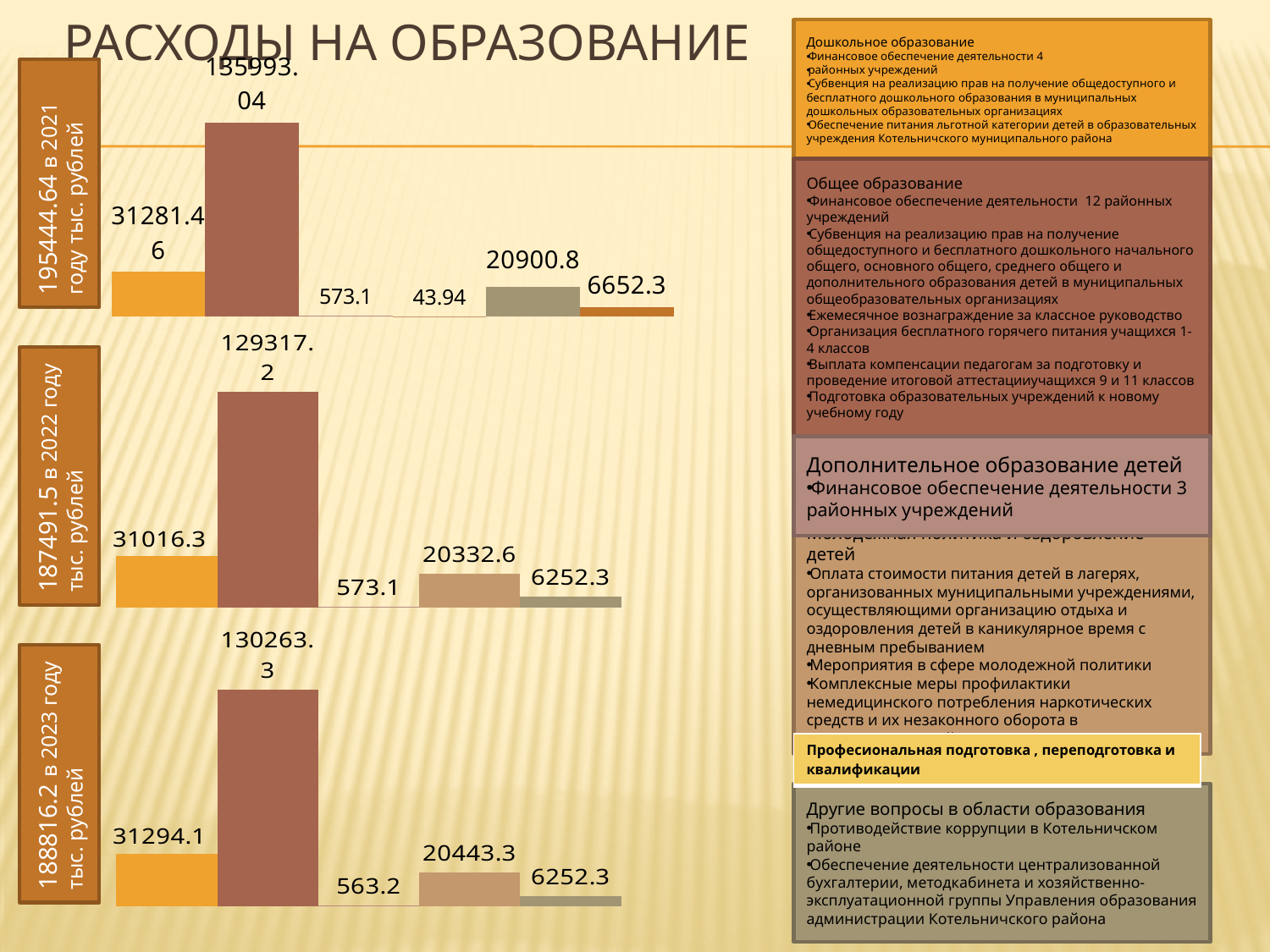
In the 2023 chart (188816.2 в 2023 году тыс. рублей), what is the value of the last (rightmost) bar? 6252.3 What is the difference between the tallest bar in the 2023 chart (130263.3) and the tallest bar in the 2022 chart (129317.2)? 946.1 What is the title of the slide containing the charts? РАСХОДЫ НА ОБРАЗОВАНИЕ In the 2023 chart, what is the difference between the first bar (31294.1) and the fourth bar (20443.3)? 10850.8 How many bars are plotted in the 2022 chart (187491.5 в 2022 году тыс. рублей)? 5 In the 2021 chart, what is the value of the fifth bar, labelled just before 6652.3? 20900.8 Which is larger: the tallest bar in the 2023 chart (130263.3) or the tallest bar in the 2022 chart (129317.2)? The 2023 chart (130263.3) How many bars are plotted in the 2021 chart? 6 In the 2022 chart, what is the value of the first (leftmost) bar? 31016.3 In the 2021 chart, what is the value of the smallest bar? 43.94 What kind of chart is used on the slide to show the education expenses for each year? Bar chart In the 2021 chart (195444.64 в 2021 году тыс. рублей), what is the value of the tallest bar? 135993.04